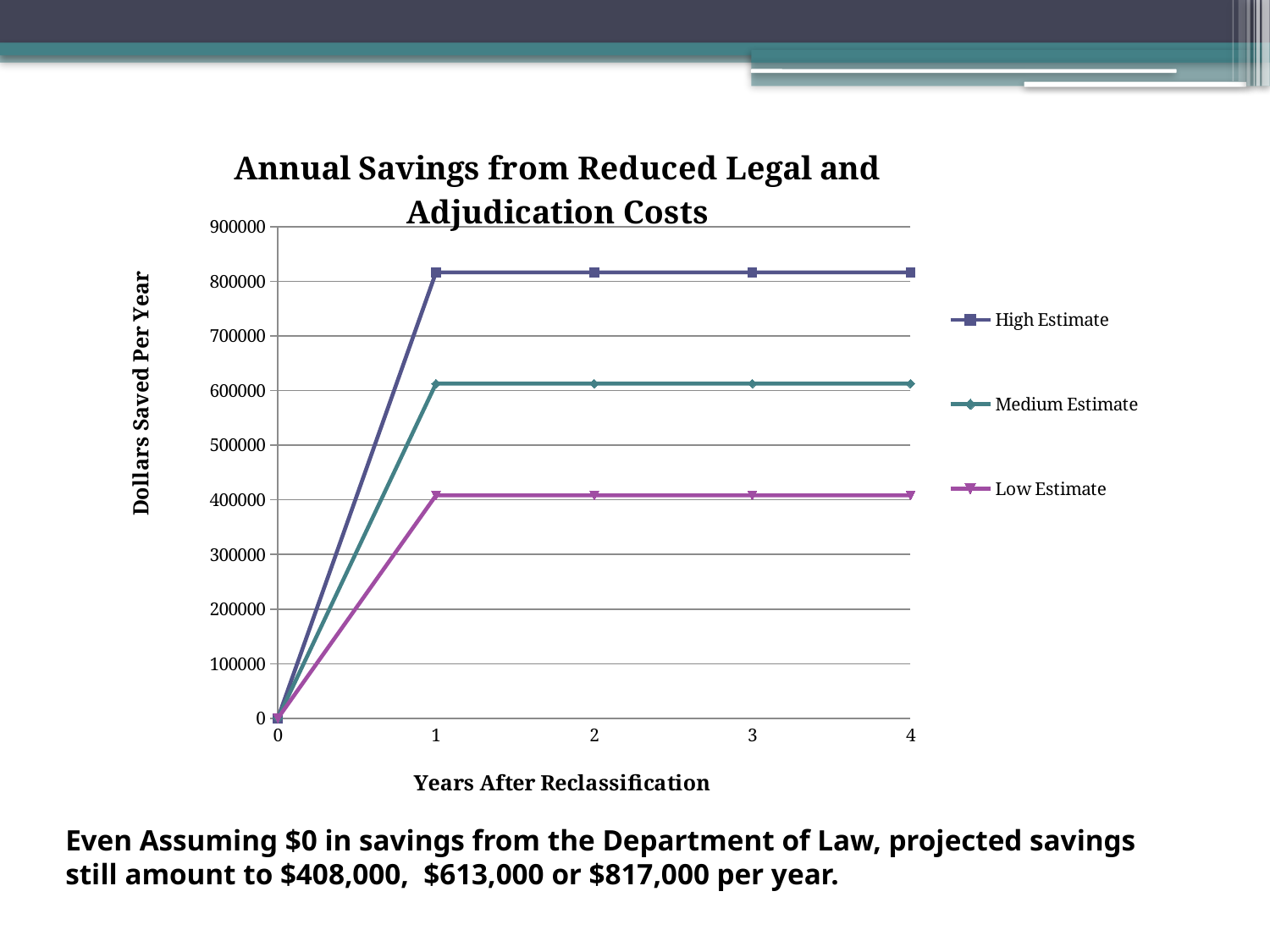
Is the Low Estimate value at year 1 greater or less than 500000? less How many series does the legend list? 3 From year 1 to year 4, does the Medium Estimate rise, fall, or stay flat? stay flat What is the value of the High Estimate at year 0? 0 Is the Medium Estimate value at year 3 greater or less than 500000? greater Which series has the highest value at year 2? High Estimate How many points along the x axis (Years After Reclassification) are plotted for each series? 5 Is the High Estimate value at year 2 greater or less than 700000? greater What kind of chart is shown on the slide? line chart At year 4, which is larger: the High Estimate or the Low Estimate? High Estimate Which series has the lowest value at year 3? Low Estimate What is the title of the y axis? Dollars Saved Per Year